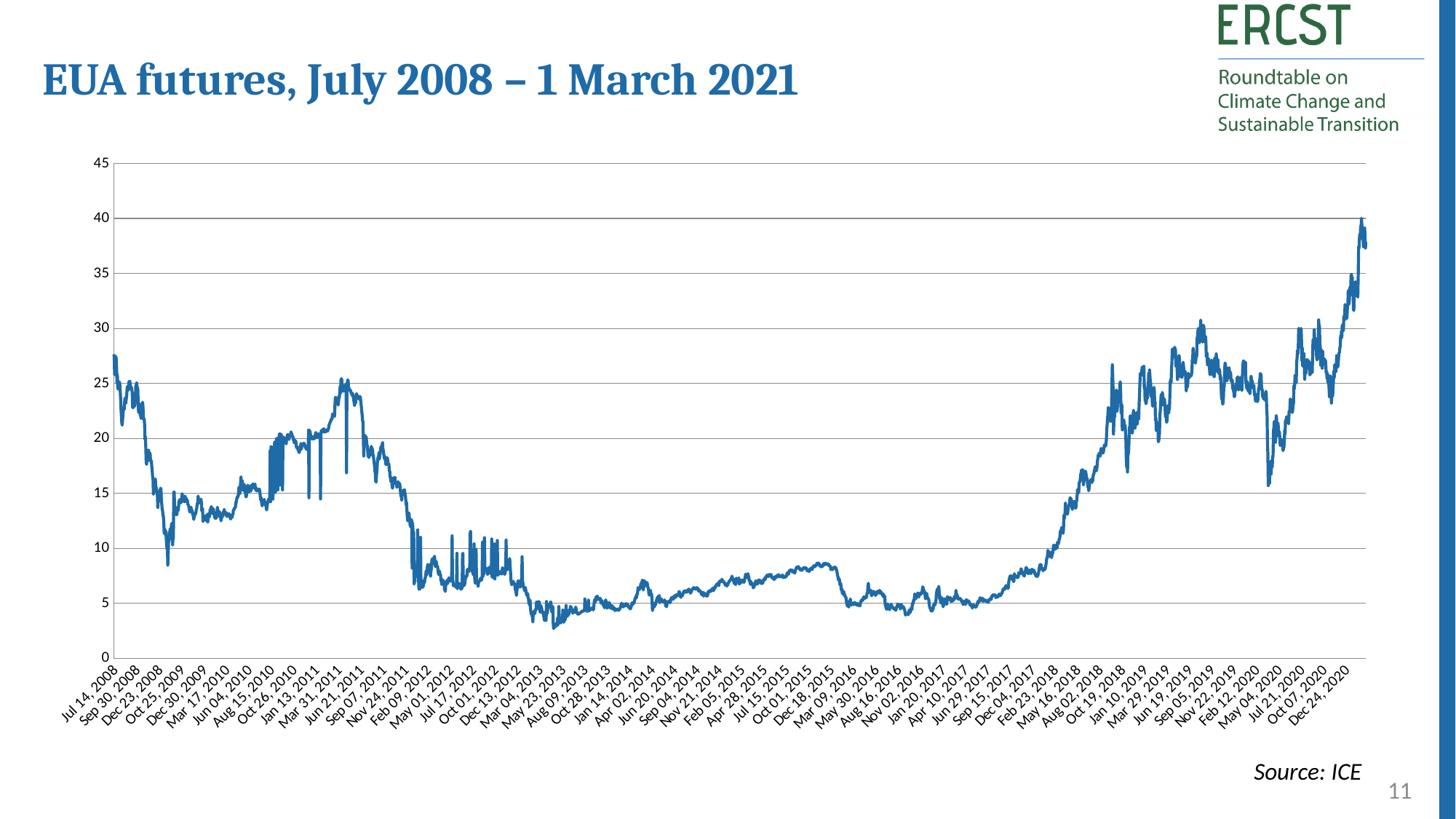
What kind of chart is shown on the slide? Line chart Does the line reach its highest value near the start or near the end of the period shown? Near the end Is the value around Oct 01, 2015 greater or less than 10? less Does the value rise or fall between Jul 14, 2008 and Dec 23, 2008? Fall Is the value at the very end of the series (early 2021) greater or less than 35? greater Is the value at the start of the series (Jul 14, 2008) greater or less than 25? greater What is the title of the chart on the slide? EUA futures, July 2008 – 1 March 2021 Does the value rise or fall between Sep 15, 2017 and Oct 19, 2018? Rise What source is cited for the chart data? ICE How many lines (series) are plotted on the chart? 1